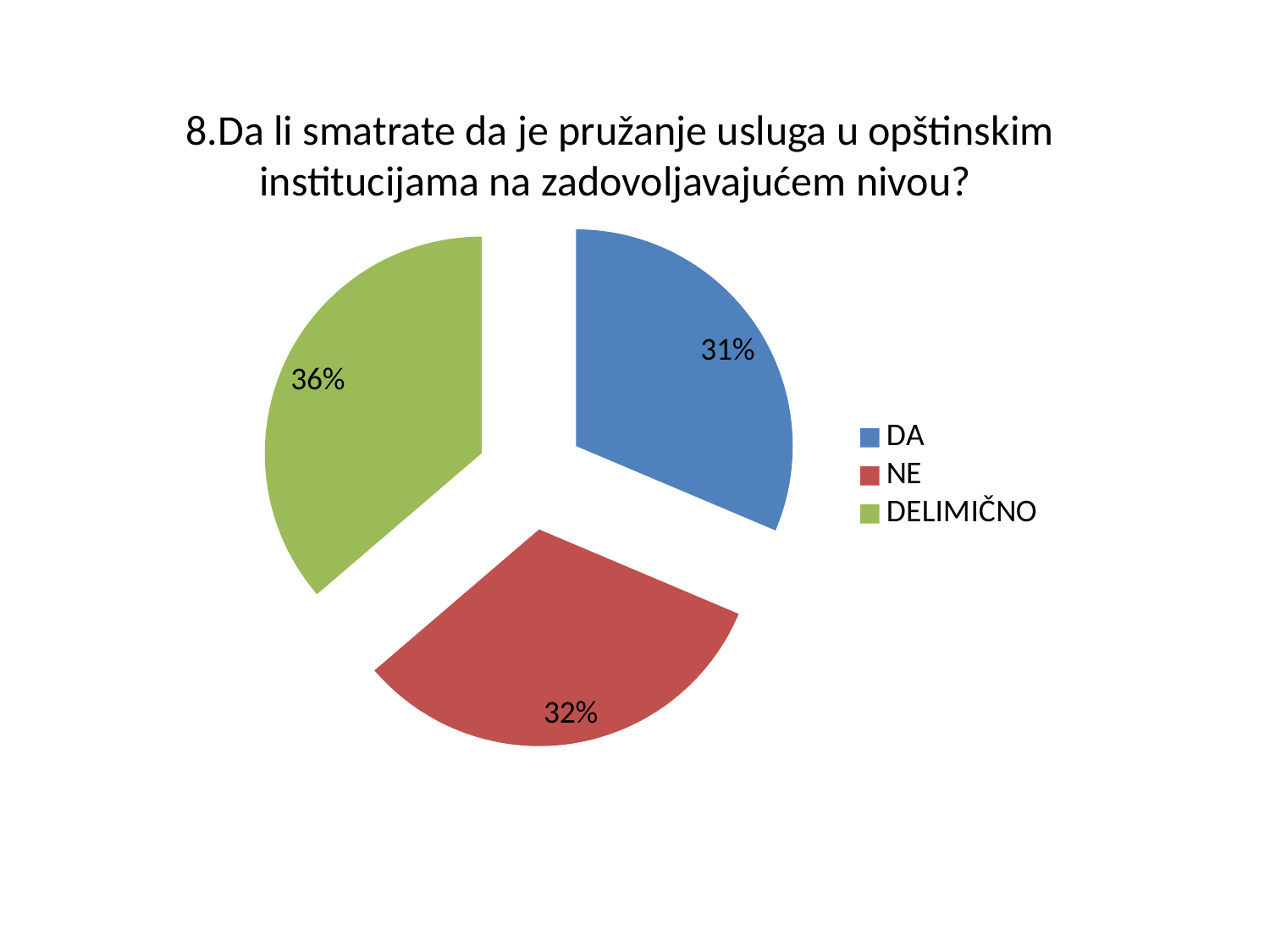
What colour is the slice for NE? Red What is the difference in percentage points between NE and DA? 1 What share of the pie does DA have? 31% What share of the pie does NE have? 32% What is the difference in percentage points between DELIMIČNO and DA? 5 Which is larger, the share for DELIMIČNO or the share for NE? DELIMIČNO Which category has the smallest slice of the pie? DA Which category has the largest slice of the pie? DELIMIČNO What is the title of the chart? 8.Da li smatrate da je pružanje usluga u opštinskim institucijama na zadovoljavajućem nivou? What kind of chart is shown on the slide? Pie chart How many categories are shown in the pie chart? 3 What share of the pie does DELIMIČNO have? 36%